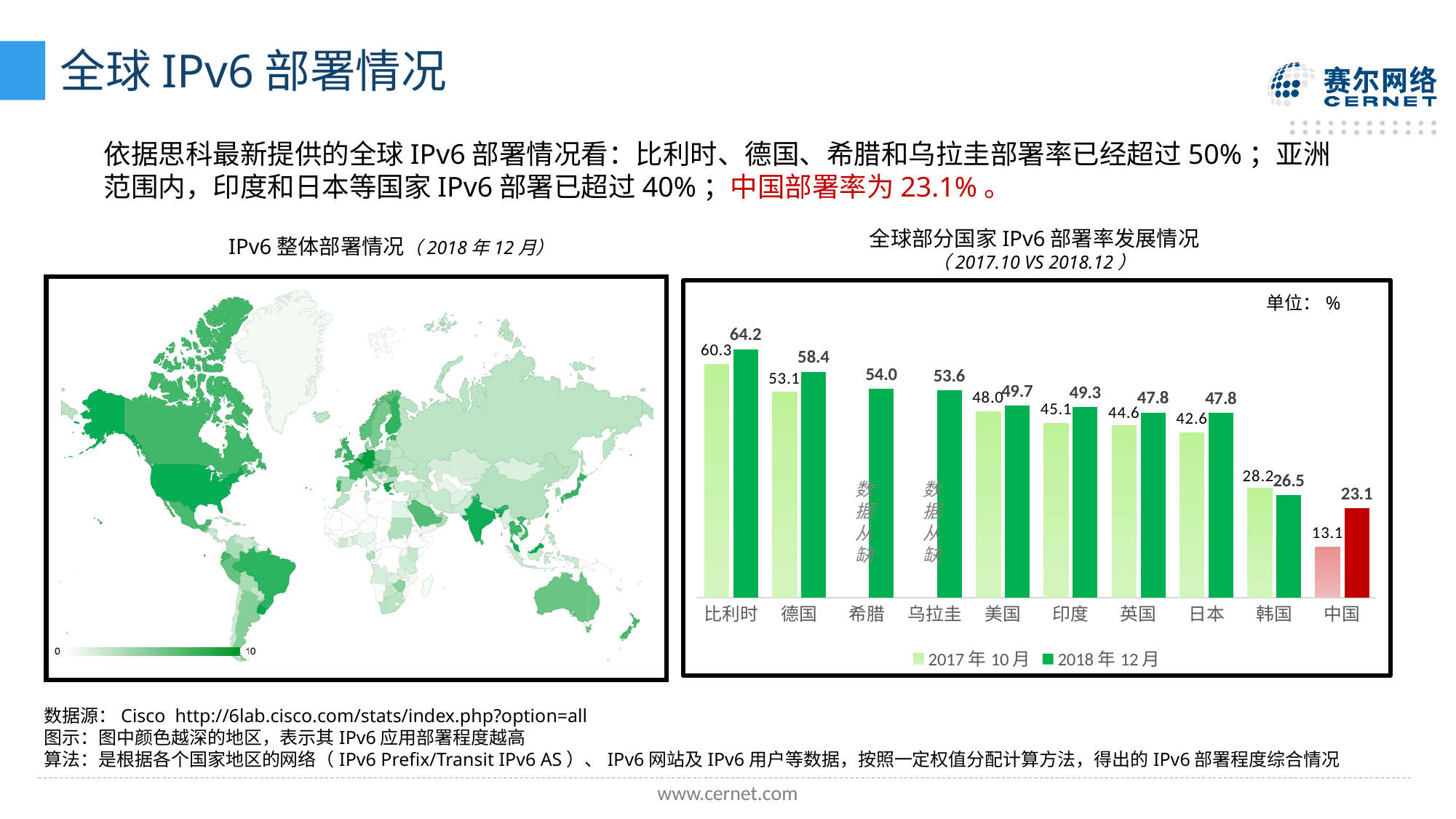
In the bar chart on the right, what is the difference between the 2018年12月 and 2017年10月 values for 中国? 10.0 In the bar chart on the right, which country has the highest 2018年12月 value? 比利时 In the bar chart on the right, which country has the lowest 2017年10月 value? 中国 In the bar chart on the right, which is larger for 韩国: the 2017年10月 value or the 2018年12月 value? 2017年10月 In the bar chart on the right, how many series does the legend list? 2 In the bar chart on the right, which two countries are marked 数据从缺 for 2017年10月? 希腊 and 乌拉圭 In the bar chart on the right, what is the 2018年12月 value for 希腊? 54.0 In the bar chart on the right, what is the 2017年10月 value for 比利时? 60.3 What kind of chart is the chart on the right? bar chart In the bar chart on the right, what is the 2018年12月 value for 中国? 23.1 In the bar chart on the right, what is the difference between the 2018年12月 values for 德国 and 日本? 10.6 In the bar chart on the right, how many countries are shown on the x axis? 10